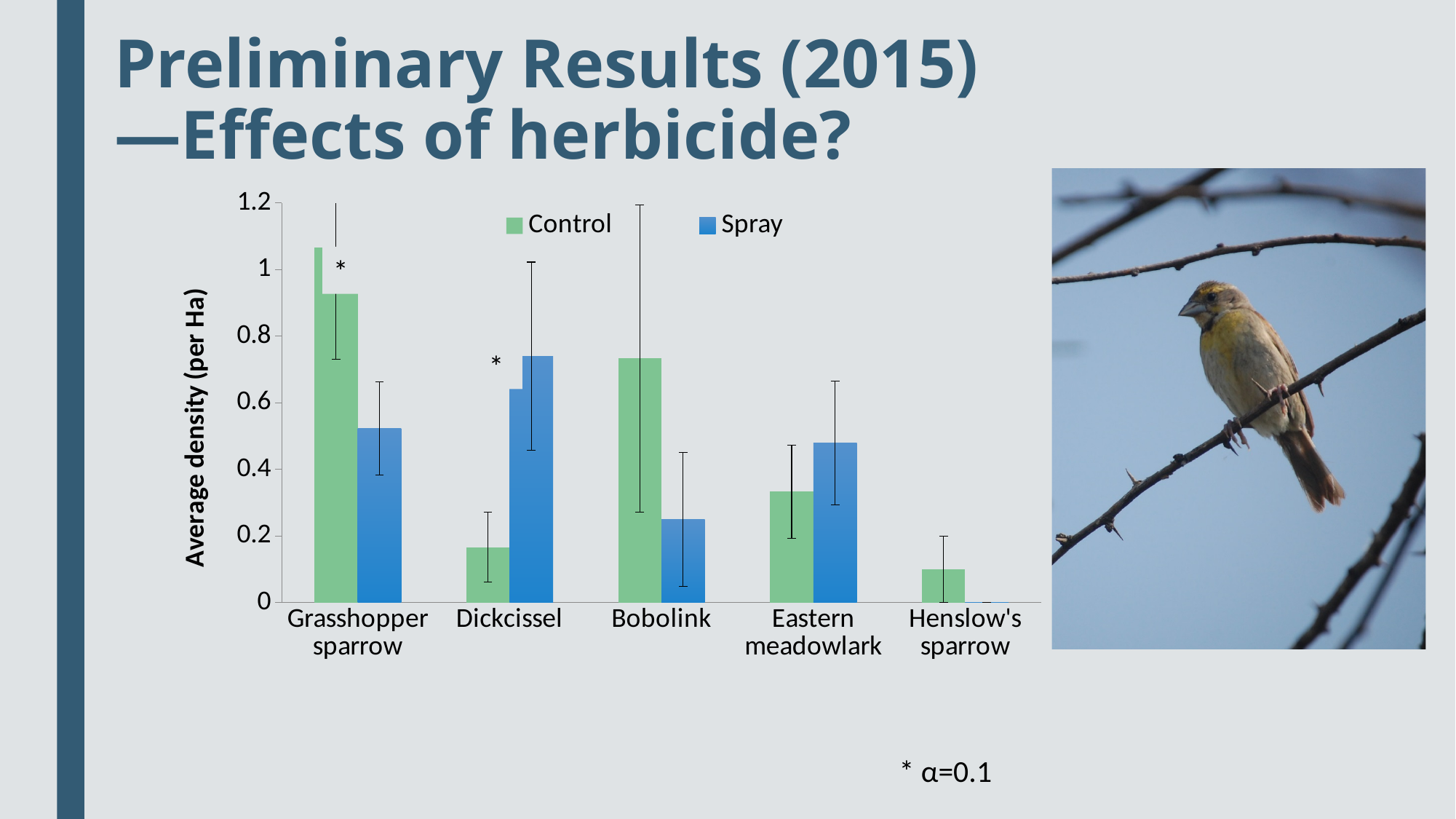
What is the label on the y axis? Average density (per Ha) Is the Spray value for Bobolink greater or less than 0.4? less How many series does the legend list? 2 For Eastern meadowlark, which is larger, the Control value or the Spray value? Spray What kind of chart is shown on the slide? bar chart How many bird species are shown on the x axis? 5 Is the Control value for Grasshopper sparrow greater or less than 0.8? greater Is the Spray value for Dickcissel greater or less than 0.6? greater Which species has the highest Control value? Grasshopper sparrow For Bobolink, which is larger, the Control value or the Spray value? Control Which species has the lowest Spray value? Henslow's sparrow